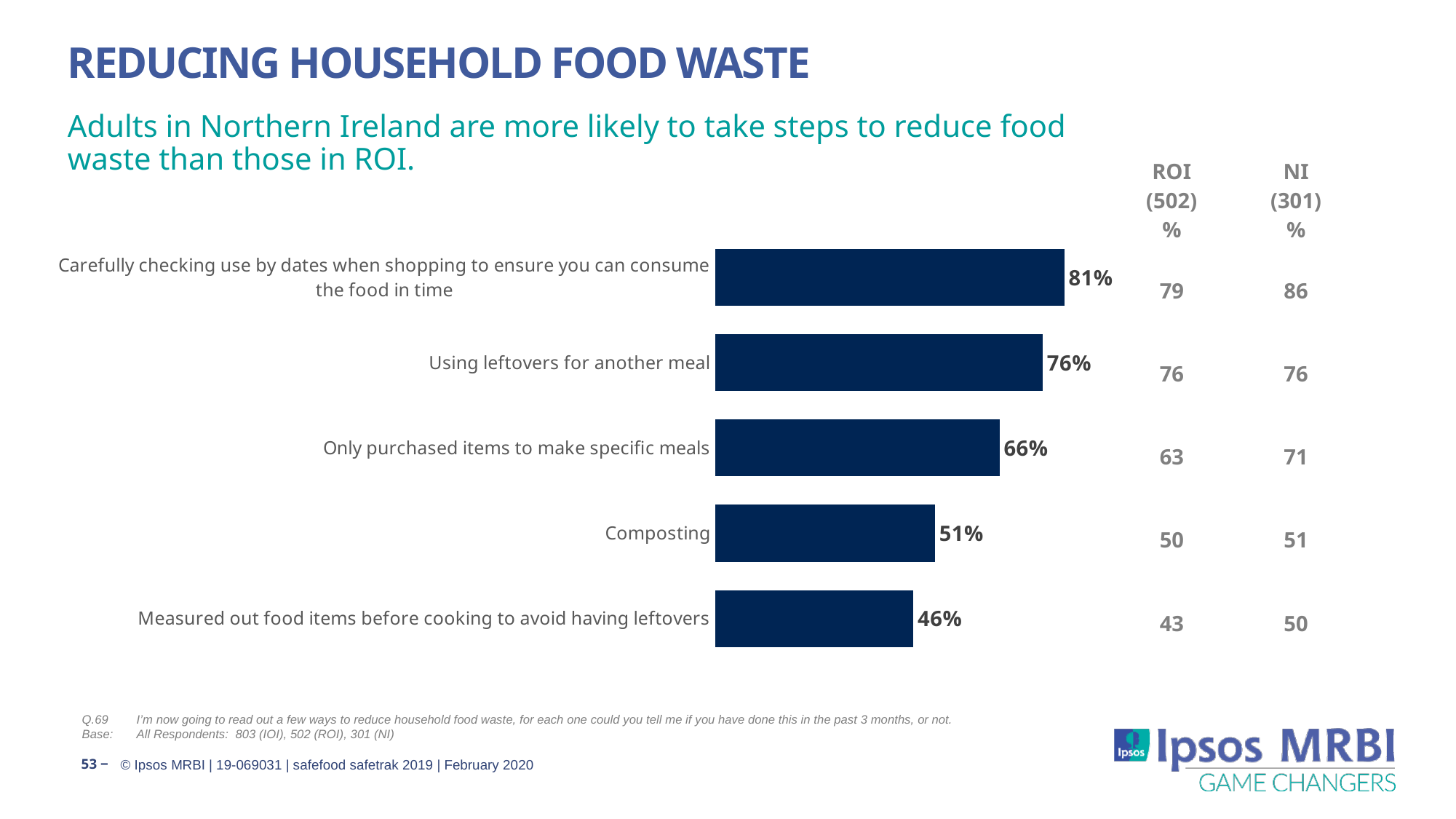
How many food waste reduction steps are plotted in the chart? 5 In the ROI column, what percentage is shown for 'Only purchased items to make specific meals'? 63 What type of chart is used on this slide? Bar chart Which food waste reduction step has the lowest percentage? Measured out food items before cooking to avoid having leftovers What is the value shown for Composting? 51% What is the value shown for 'Measured out food items before cooking to avoid having leftovers'? 46% In the NI column, what percentage is shown for 'Carefully checking use by dates when shopping to ensure you can consume the food in time'? 86 Which food waste reduction step has the highest percentage? Carefully checking use by dates when shopping to ensure you can consume the food in time What percentage of respondents reported carefully checking use by dates when shopping to ensure they can consume the food in time? 81% What is the title of the slide containing the chart? REDUCING HOUSEHOLD FOOD WASTE What is the difference in percentage points between 'Using leftovers for another meal' and 'Only purchased items to make specific meals'? 10 Which is larger: the value for Composting or the value for 'Only purchased items to make specific meals'? Only purchased items to make specific meals